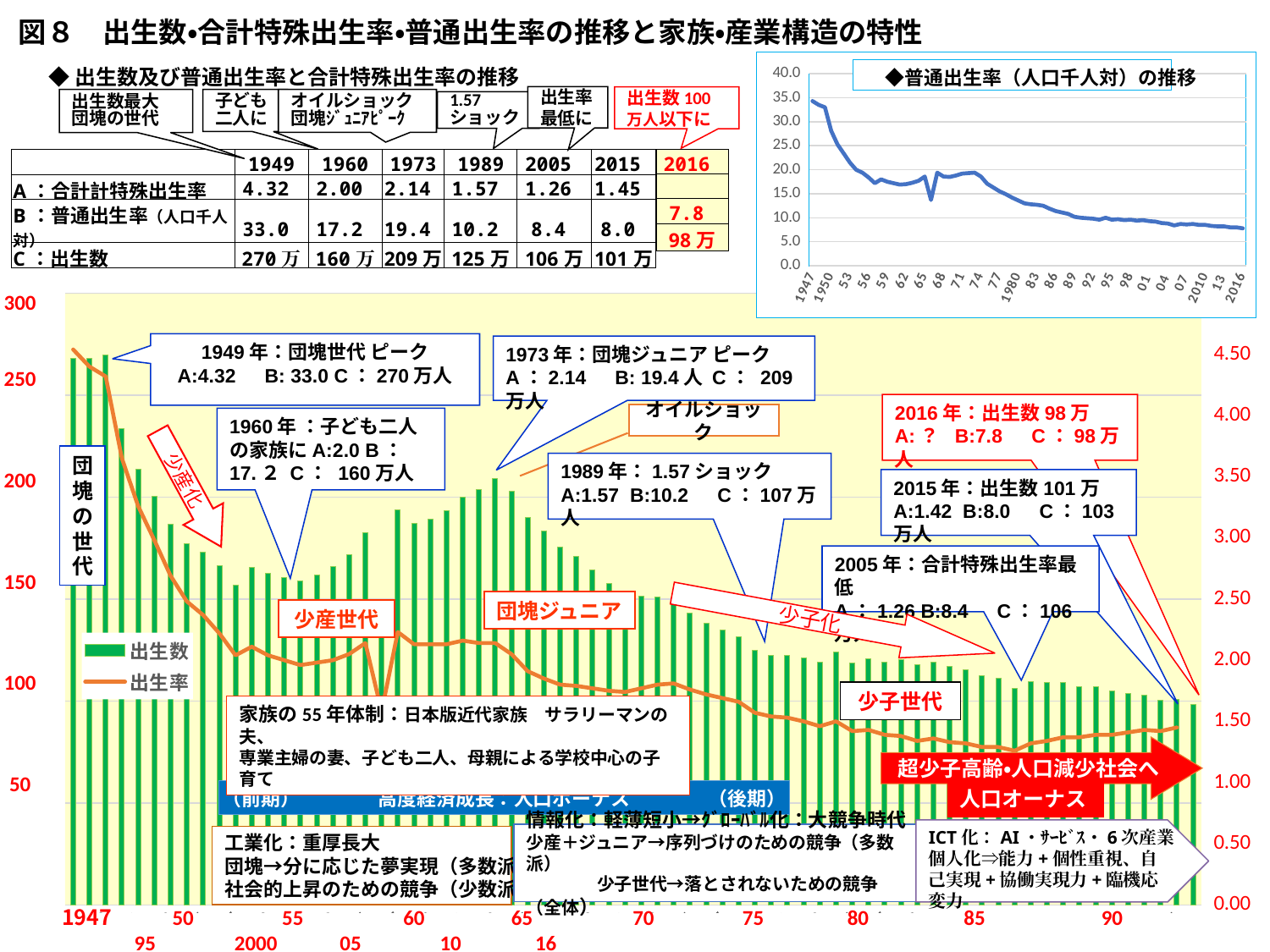
What are the two legend entries of the large main chart? 出生数, 出生率 How many series does the legend of the large main chart list? 2 In the small top-right chart (普通出生率の推移), is the value for 2016 greater or less than 10.0? less In the large main chart, what is the 出生数 given in the red callout for 2016? 98万 What kind of chart is the small chart in the top right titled ◆普通出生率（人口千人対）の推移? line chart In the large main chart, which year has the taller 出生数 bar, 1949 or 1973? 1949 In the large main chart, what is the value of A (合計特殊出生率) given in the callout for 1973? 2.14 What is the title of the small chart in the top right of the slide? ◆普通出生率（人口千人対）の推移 In the large main chart, what is the 出生数 (C) given in the callout for 1949? 270万人 In the small top-right chart (普通出生率の推移), do the values rise or fall from 1947 to 2016? fall In the large main chart, is the 出生数 bar for 1989 greater or less than 150 on the left axis? less In the small top-right chart (普通出生率の推移), is the value for 1947 greater or less than 30.0? greater